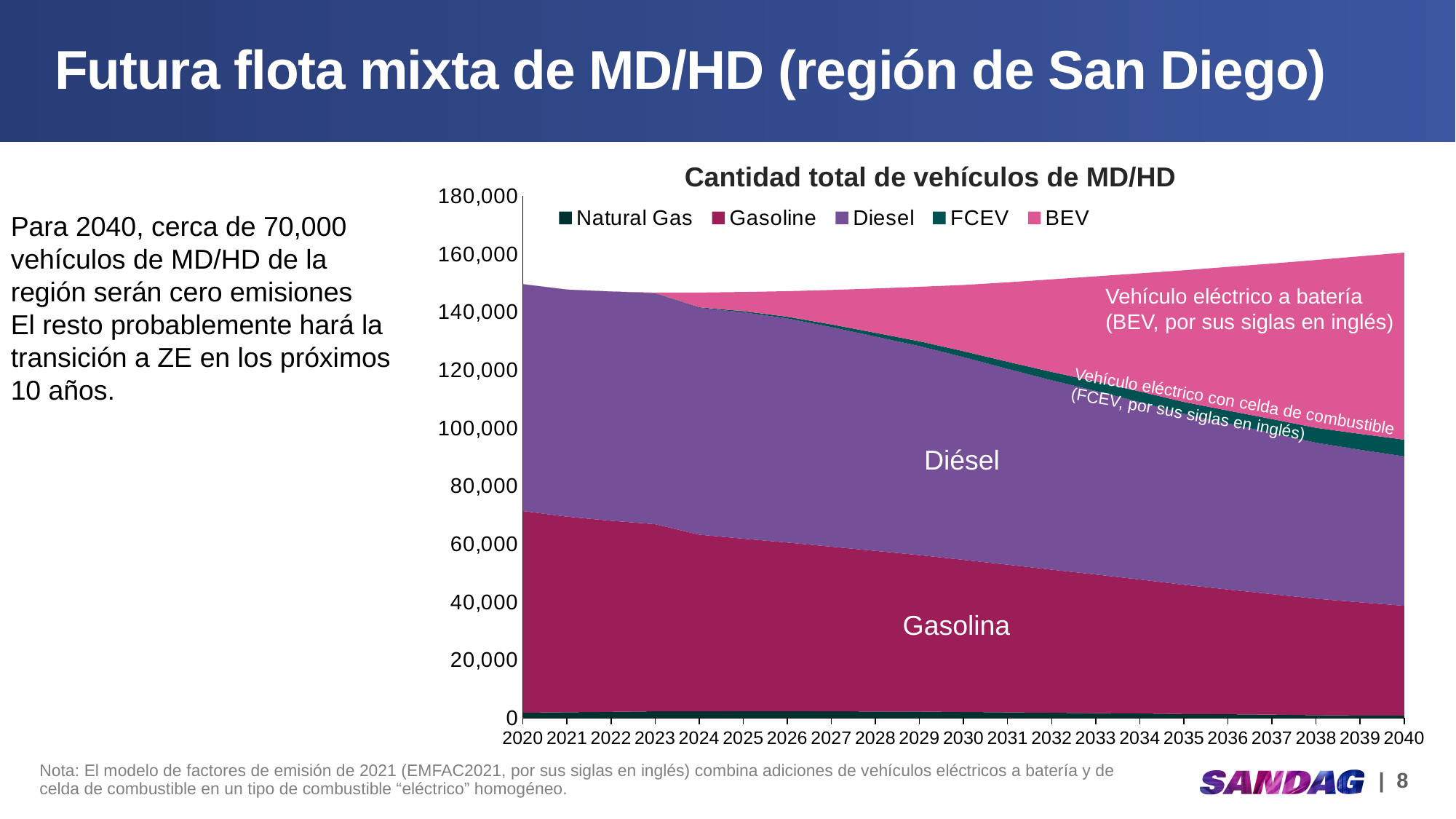
Is the total number of vehicles in 2040 greater or less than 140,000? greater How many years are shown along the x axis of the chart? 21 What is the title of the chart? Cantidad total de vehículos de MD/HD In 2040, which is larger, the Diesel value or the Gasoline value? Diesel Does the BEV area rise or fall from 2020 to 2040? Rises How many series does the chart legend list? 5 Is the total number of vehicles in 2020 greater or less than 160,000? less Which series is listed first in the chart legend? Natural Gas In 2040, which is larger, the BEV value or the Gasoline value? BEV Does the Gasoline area rise or fall from 2020 to 2040? Falls Is the Gasoline value in 2040 greater or less than 60,000? less What kind of chart is shown on the slide? Stacked area chart